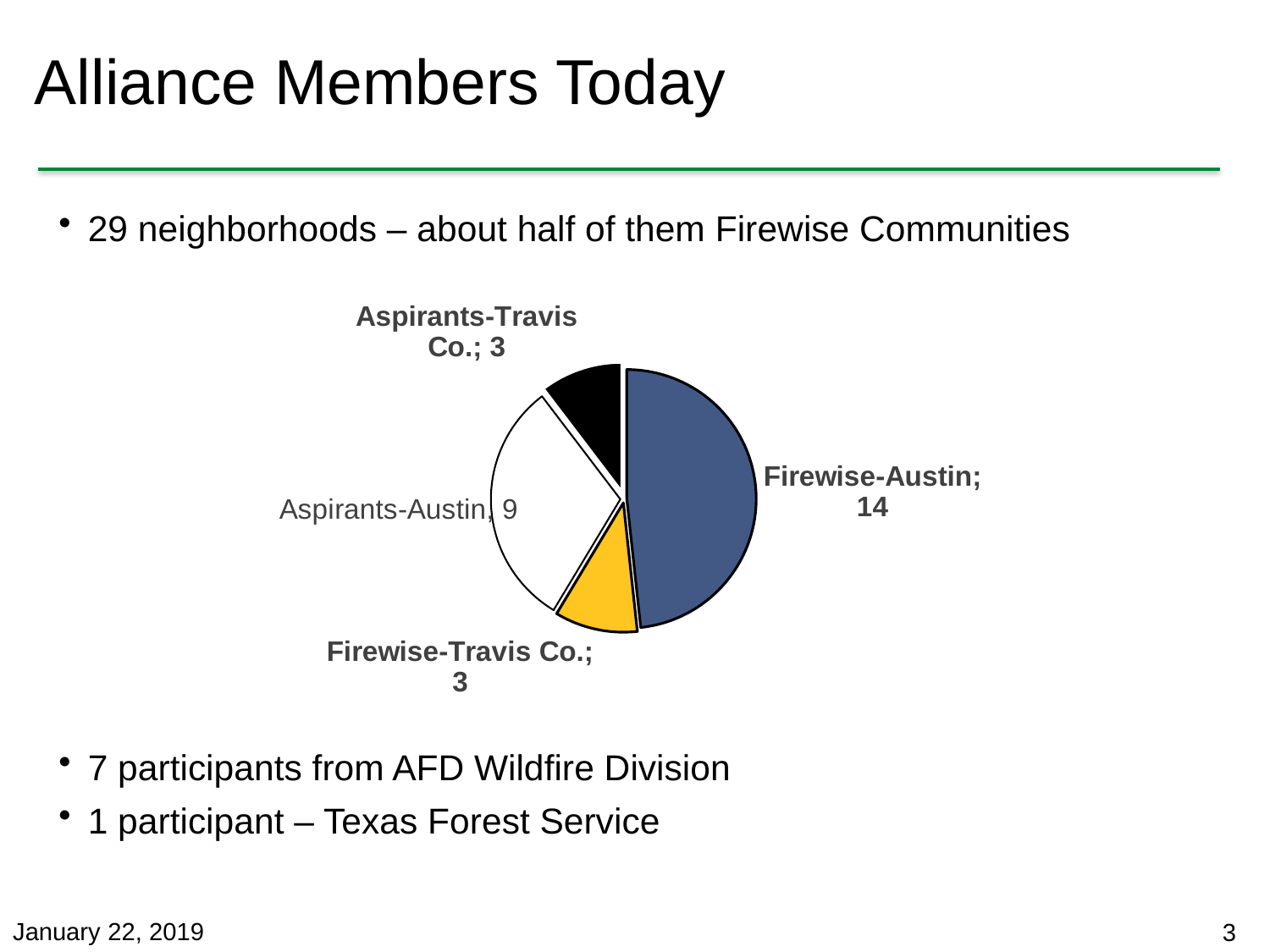
What is the difference between the Aspirants-Austin and Firewise-Travis Co. values? 6 Which category has the largest slice in the pie chart? Firewise-Austin What kind of chart is shown on the slide? pie chart What is the difference between the Firewise-Austin and Aspirants-Austin values? 5 What is the value for Firewise-Austin in the pie chart? 14 What is the value for Aspirants-Travis Co. in the pie chart? 3 How many slices does the pie chart have? 4 Which is larger, Aspirants-Austin or Aspirants-Travis Co.? Aspirants-Austin What is the total of all the slices in the pie chart? 29 What is the value for Firewise-Travis Co. in the pie chart? 3 What is the value for Aspirants-Austin in the pie chart? 9 What colour is the Firewise-Travis Co. slice in the pie chart? yellow